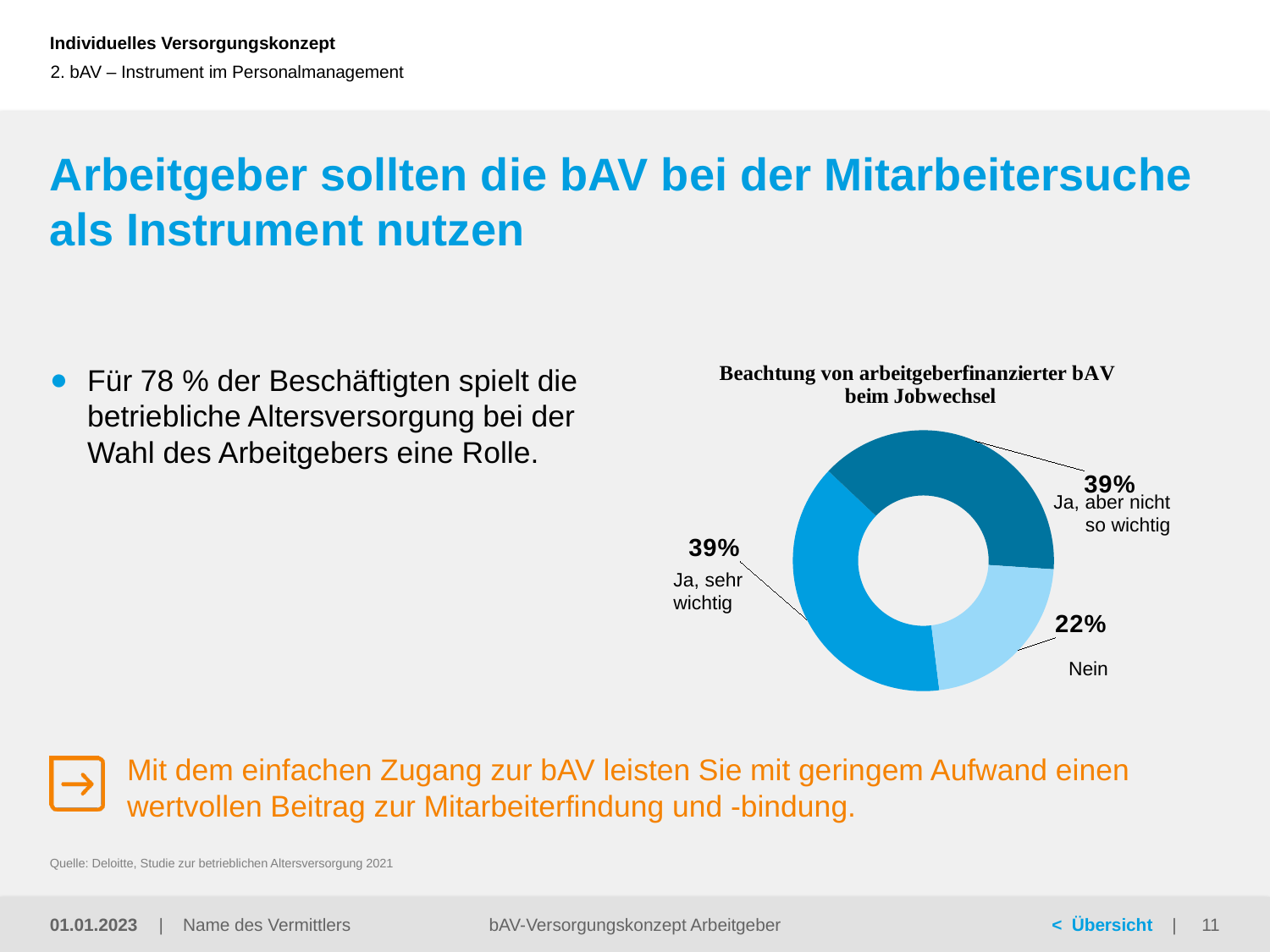
What is the value for "Nein" in the chart? 22% What share of the chart does the "Nein" slice represent? 22% Which two categories in the chart have the same value? Ja, sehr wichtig and Ja, aber nicht so wichtig What is the difference in percentage points between "Ja, sehr wichtig" and "Nein"? 17 percentage points How many categories does the chart show? 3 Which is larger in the chart: "Nein" or "Ja, sehr wichtig"? Ja, sehr wichtig What is the title of the chart on the slide? Beachtung von arbeitgeberfinanzierter bAV beim Jobwechsel Which category has the smallest share in the chart? Nein What is the value for "Ja, sehr wichtig" in the chart? 39% What is the value for "Ja, aber nicht so wichtig" in the chart? 39% What is the combined share of the two "Ja" categories ("Ja, sehr wichtig" and "Ja, aber nicht so wichtig")? 78% What kind of chart is shown on the slide? Donut (pie) chart